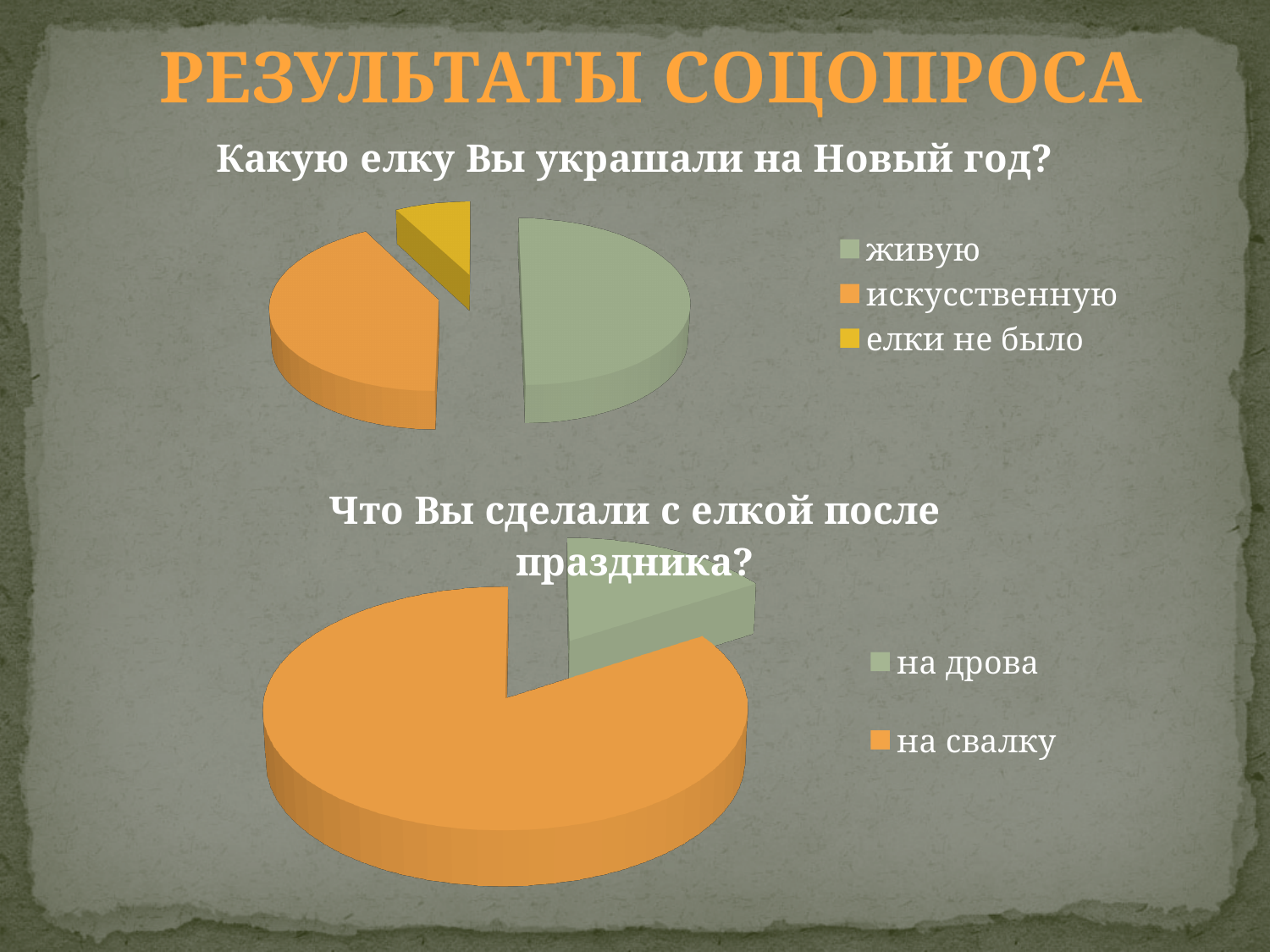
In the top chart, which slice is larger: "искусственную" or "елки не было"? искусственную In the bottom chart, what colour is the slice for "на свалку"? orange In the bottom chart ("Что Вы сделали с елкой после праздника?"), how many slices does the pie have? 2 In the top chart ("Какую елку Вы украшали на Новый год?"), how many slices does the pie have? 3 In the top chart ("Какую елку Вы украшали на Новый год?"), which category has the smallest slice? елки не было How many entries does the legend of the top chart list? 3 In the bottom chart ("Что Вы сделали с елкой после праздника?"), which category has the largest slice? на свалку What kind of chart is used for the question "Что Вы сделали с елкой после праздника?"? pie chart What kind of chart is used for the question "Какую елку Вы украшали на Новый год?"? pie chart How many entries does the legend of the bottom chart list? 2 In the top chart ("Какую елку Вы украшали на Новый год?"), which category has the largest slice? живую In the bottom chart ("Что Вы сделали с елкой после праздника?"), which category has the smallest slice? на дрова